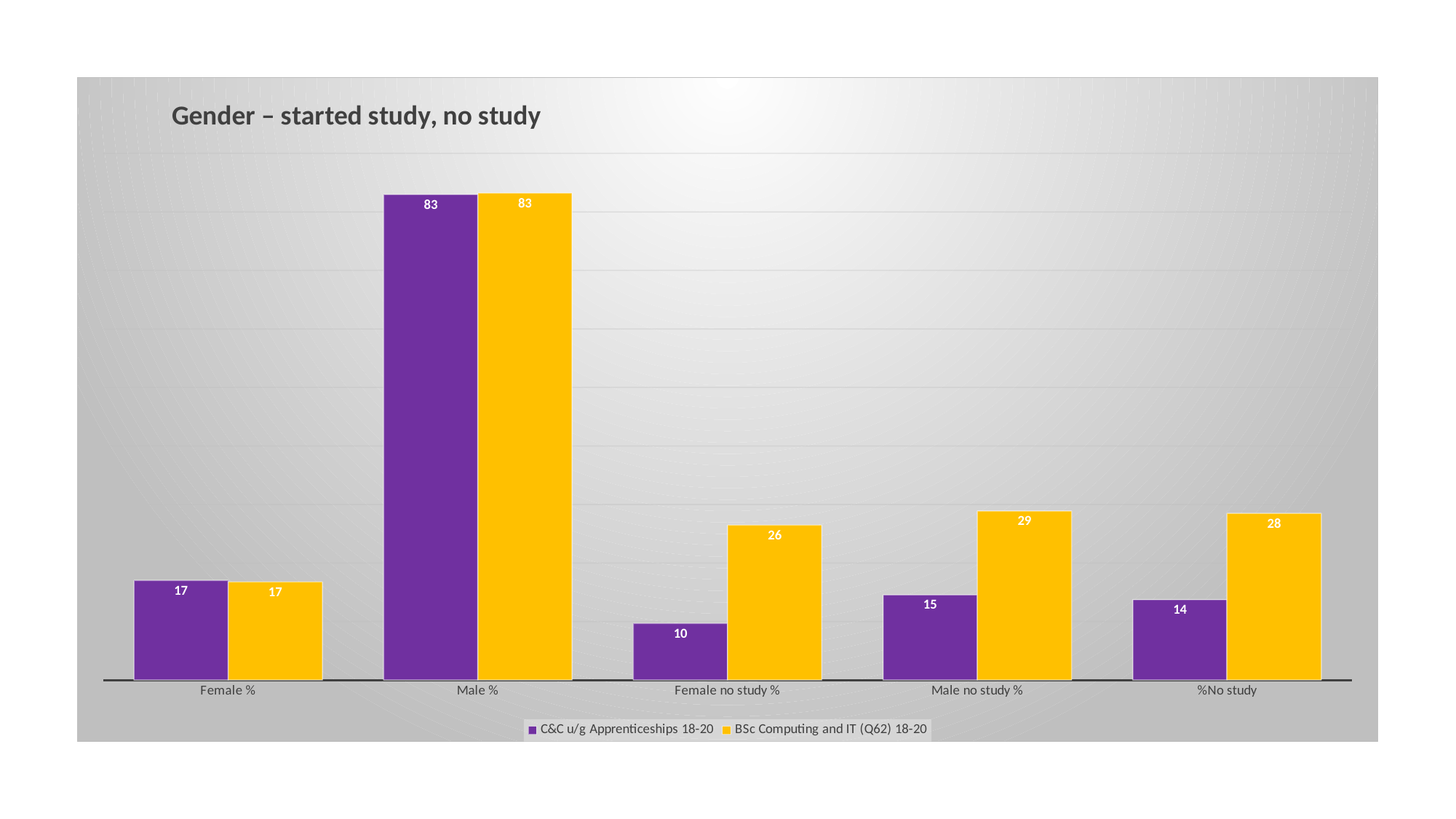
What colour are the bars for the BSc Computing and IT (Q62) 18-20 series? Yellow Which category has the highest value in the BSc Computing and IT (Q62) 18-20 series? Male % What is the value for Male no study % in the BSc Computing and IT (Q62) 18-20 series? 29 What is the value for Female no study % in the C&C u/g Apprenticeships 18-20 series? 10 What kind of chart is shown on the slide? Bar chart For %No study, which series has the larger value? BSc Computing and IT (Q62) 18-20 Which category has the lowest value in the C&C u/g Apprenticeships 18-20 series? Female no study % What is the value for %No study in the C&C u/g Apprenticeships 18-20 series? 14 How many series does the legend list? 2 What is the difference between the BSc Computing and IT (Q62) 18-20 value and the C&C u/g Apprenticeships 18-20 value for Female no study %? 16 How many categories are shown on the x axis? 5 What is the title of the chart? Gender – started study, no study